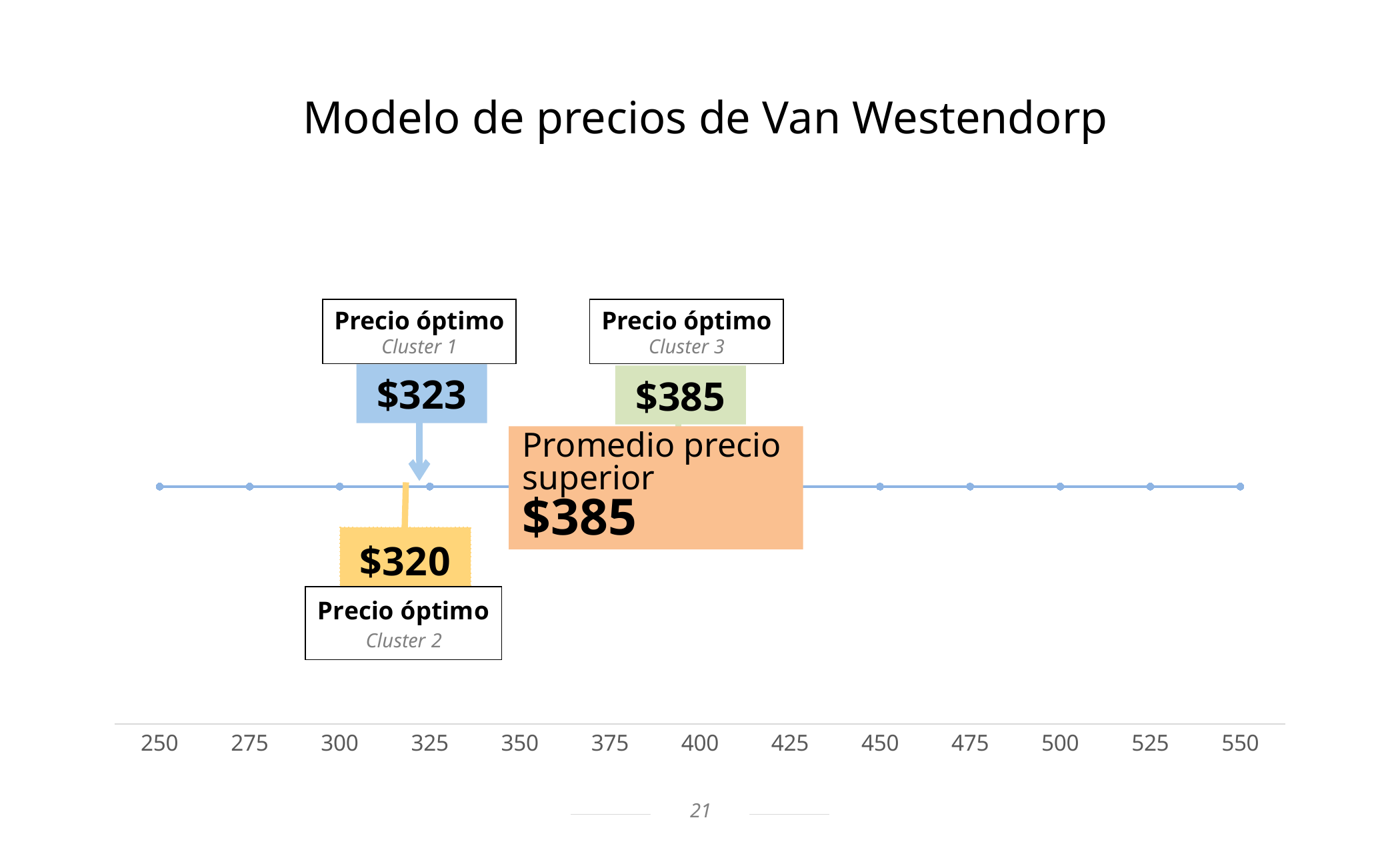
Which cluster has the highest Precio óptimo? Cluster 3 What is the title of the chart? Modelo de precios de Van Westendorp Which is larger, the Precio óptimo of Cluster 1 or of Cluster 2? Cluster 1 What is the difference between the Precio óptimo of Cluster 3 and Cluster 1? $62 Is the Precio óptimo for Cluster 3 greater or less than 350? greater What is the difference between the Precio óptimo of Cluster 1 and Cluster 2? $3 What is the Promedio precio superior shown on the chart? $385 Which cluster has the lowest Precio óptimo? Cluster 2 What is the Precio óptimo for Cluster 2? $320 What is the lowest value shown on the x axis? 250 What is the Precio óptimo for Cluster 1? $323 What is the Precio óptimo for Cluster 3? $385